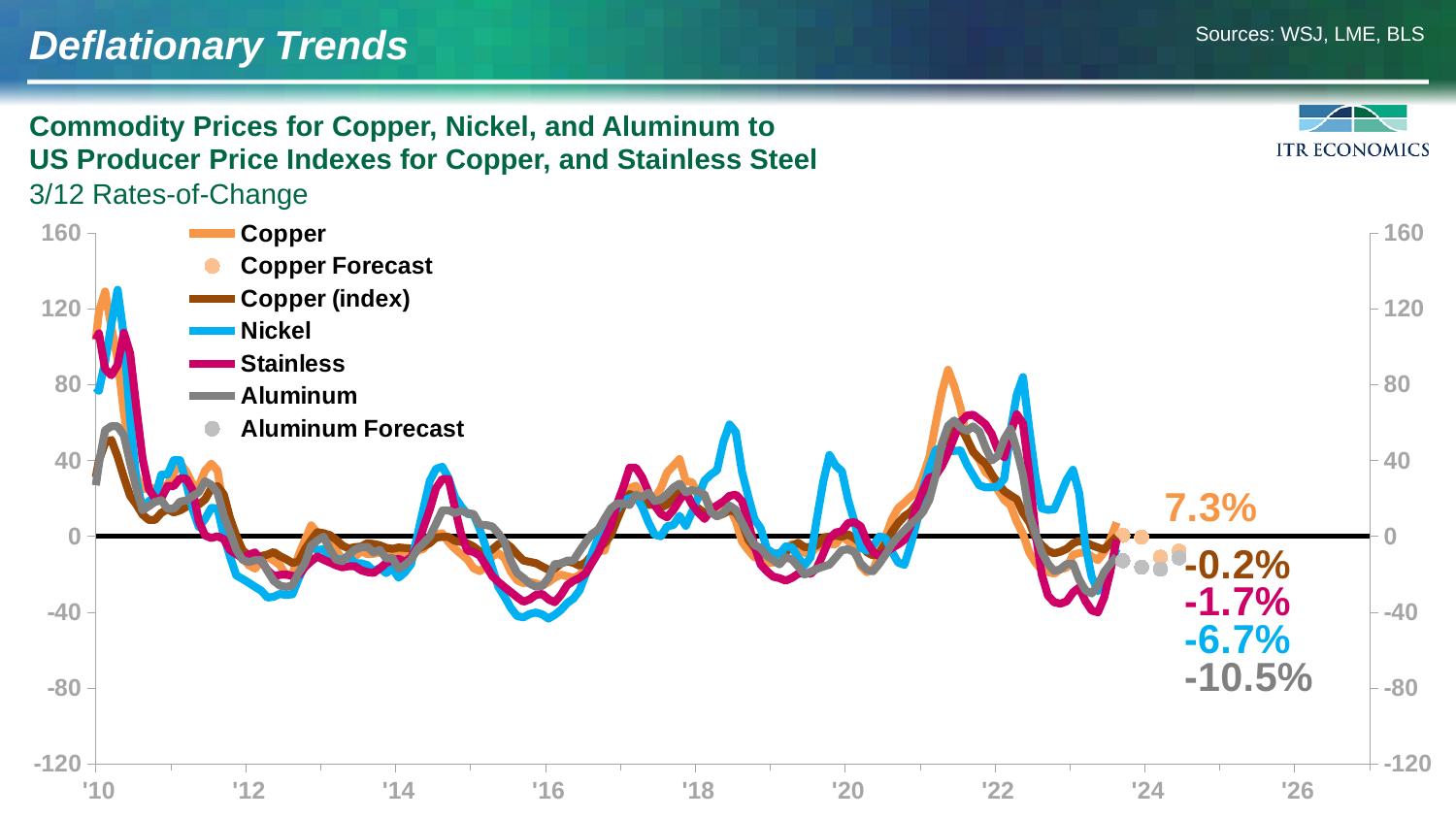
How many series does the legend list? 7 What is the latest labeled value for Aluminum on the chart? -10.5% Is the peak value for Nickel around 2010 greater or less than 120? greater What is the latest labeled value for Copper on the chart? 7.3% What is the difference between the latest labeled values for Copper (7.3%) and Aluminum (-10.5%)? 17.8 percentage points Which has a higher latest labeled value, Nickel or Stainless? Stainless Which series has the lowest latest labeled value on the chart? Aluminum What is the latest labeled value for Copper (index) on the chart? -0.2% Which series has the highest latest labeled value on the chart? Copper What is the latest labeled value for Nickel on the chart? -6.7% What kind of chart is shown on the slide? Line chart What is the latest labeled value for Stainless on the chart? -1.7%